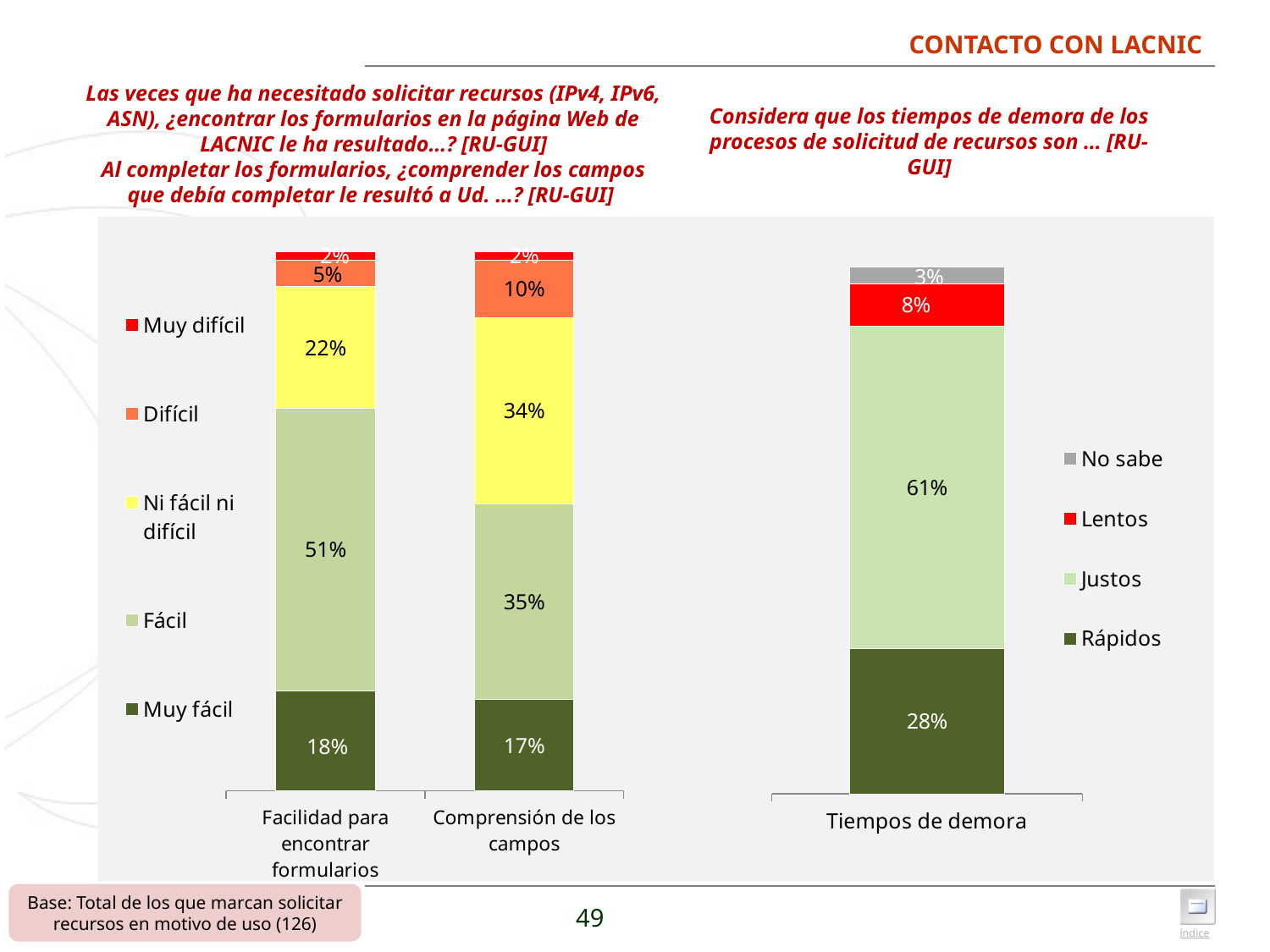
In the right chart, what is the value for Lentos? 8% What kind of chart is the right chart? Stacked bar chart In the right chart, which category has the lowest value? No sabe In the right chart, what is the value for Justos? 61% In the left chart, what is the value for Ni fácil ni difícil in the Comprensión de los campos bar? 34% In the left chart, what is the value for Difícil in the Comprensión de los campos bar? 10% In the right chart, what is the difference between Justos and Rápidos? 33% In the left chart, which series has the largest value in the Facilidad para encontrar formularios bar? Fácil In the left chart, which is larger: Muy fácil for Facilidad para encontrar formularios or Muy fácil for Comprensión de los campos? Facilidad para encontrar formularios How many series does the legend of the left chart list? 5 In the left chart, what is the difference between the Fácil values for Facilidad para encontrar formularios and Comprensión de los campos? 16% In the left chart, what is the value for Fácil in the Facilidad para encontrar formularios bar? 51%